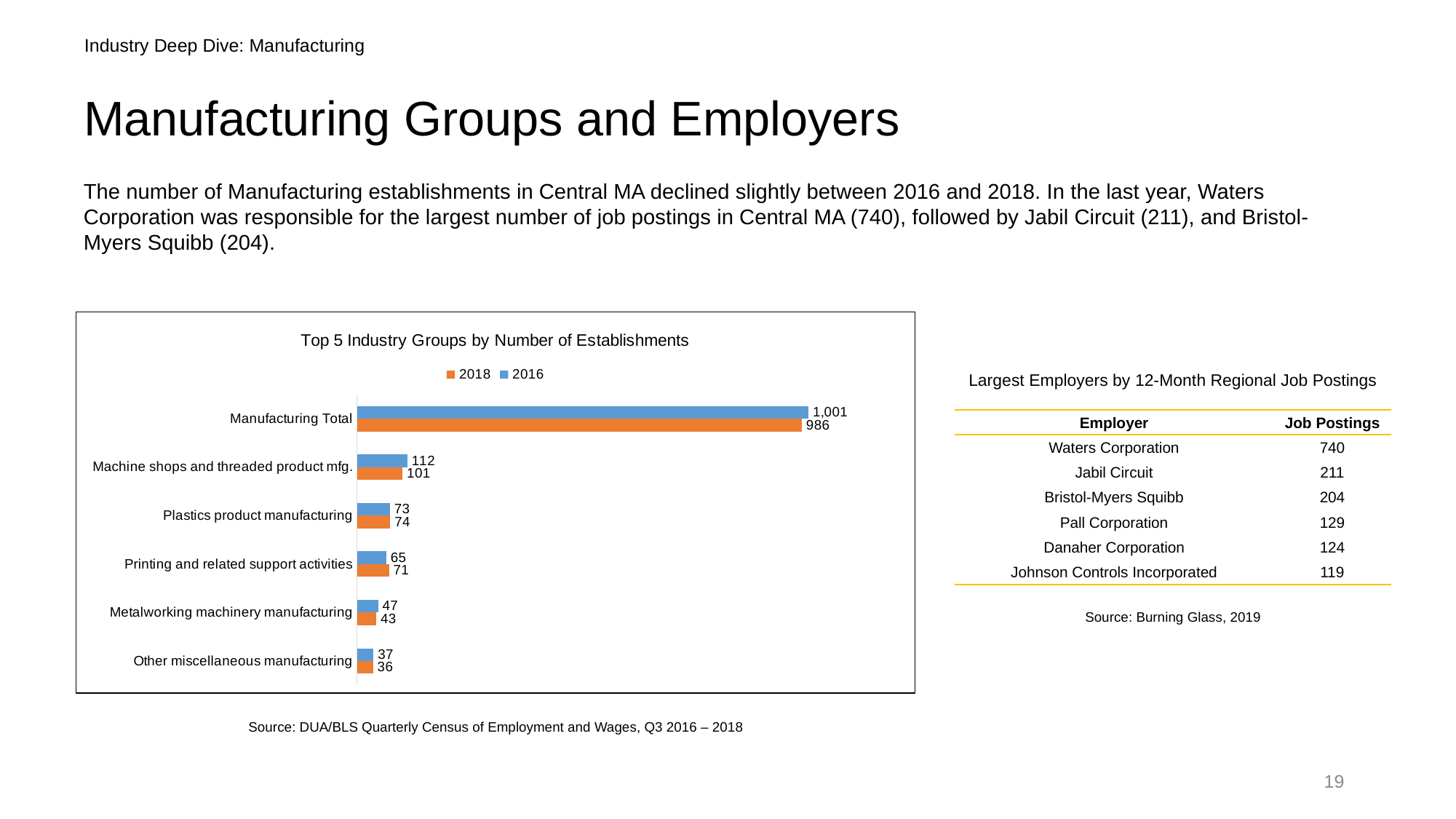
What is the difference between the 2016 and 2018 values for Manufacturing Total? 15 What is the title of the chart? Top 5 Industry Groups by Number of Establishments How many categories are plotted in the chart? 6 What type of chart is shown on the slide? bar chart What is the 2018 value for Printing and related support activities? 71 What is the difference between the 2016 and 2018 values for Machine shops and threaded product mfg.? 11 What is the 2018 value for Machine shops and threaded product mfg.? 101 Which category has the lowest 2018 value? Other miscellaneous manufacturing Is the 2016 value for Metalworking machinery manufacturing larger or smaller than the 2018 value? larger How many series does the legend of the chart list? 2 What is the 2016 value for Manufacturing Total? 1,001 Excluding Manufacturing Total, which category has the highest 2016 value? Machine shops and threaded product mfg.